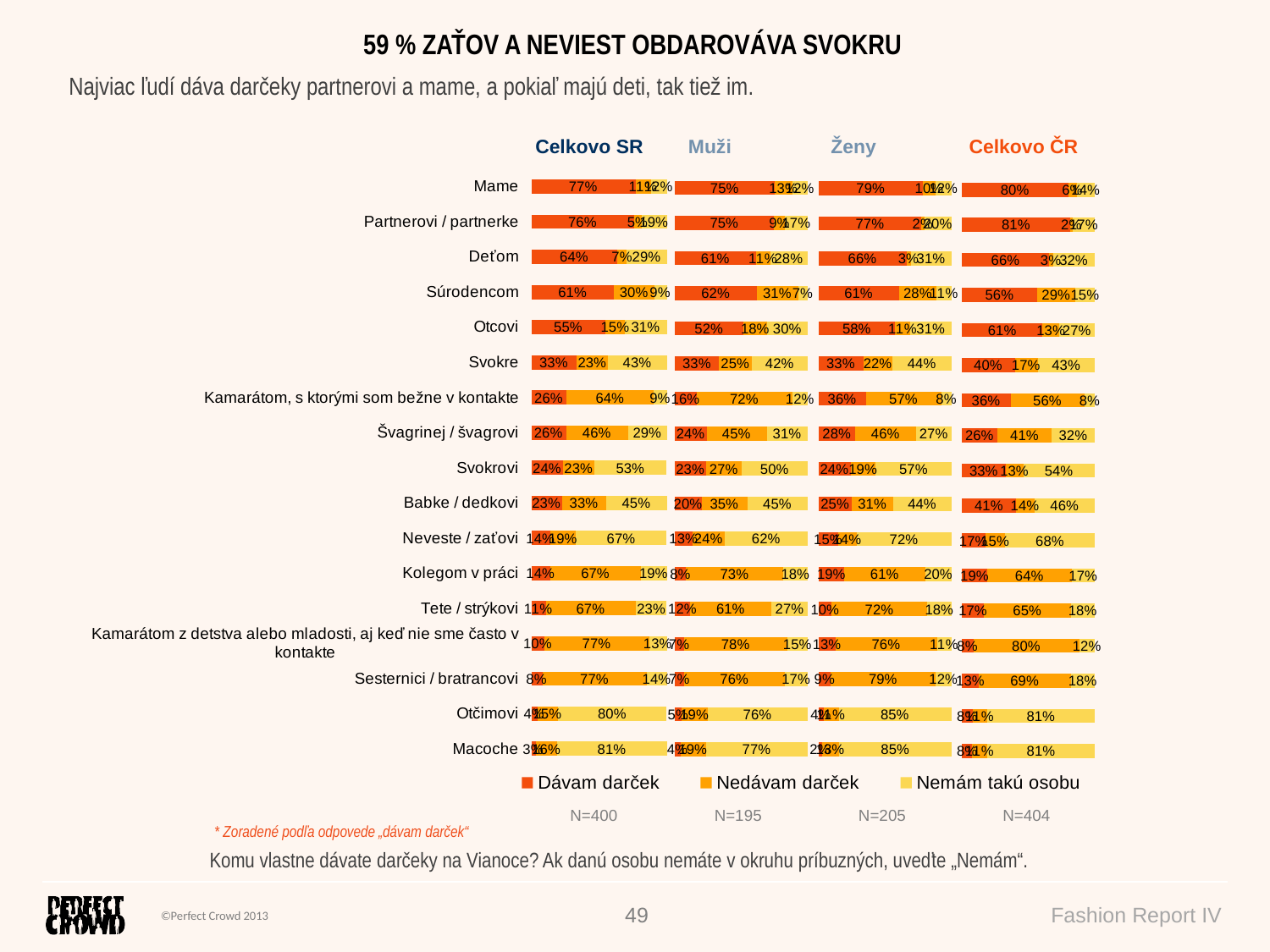
In the Ženy chart, what is the Nemám takú osobu value for Svokrovi? 57% In the Celkovo SR chart, which category has the highest Dávam darček value? Mame In the Muži chart, which is larger: the Dávam darček value for Súrodencom or for Deťom? Súrodencom What kind of chart is used on this slide? Stacked bar chart In the Ženy chart, which category has the lowest Dávam darček value? Macoche What is the sample size (N) shown under the Celkovo ČR chart? N=404 In the Muži chart, what is the Dávam darček value for Otcovi? 52% In the Celkovo SR chart, what is the difference between the Dávam darček values for Mame and Otcovi? 22% In the Celkovo SR chart, what percentage of respondents give a gift (Dávam darček) to their mother (Mame)? 77% How many categories (rows) are shown in each chart? 17 In the Celkovo ČR chart, what is the Dávam darček value for Partnerovi / partnerke? 81% How many series does the legend list? 3